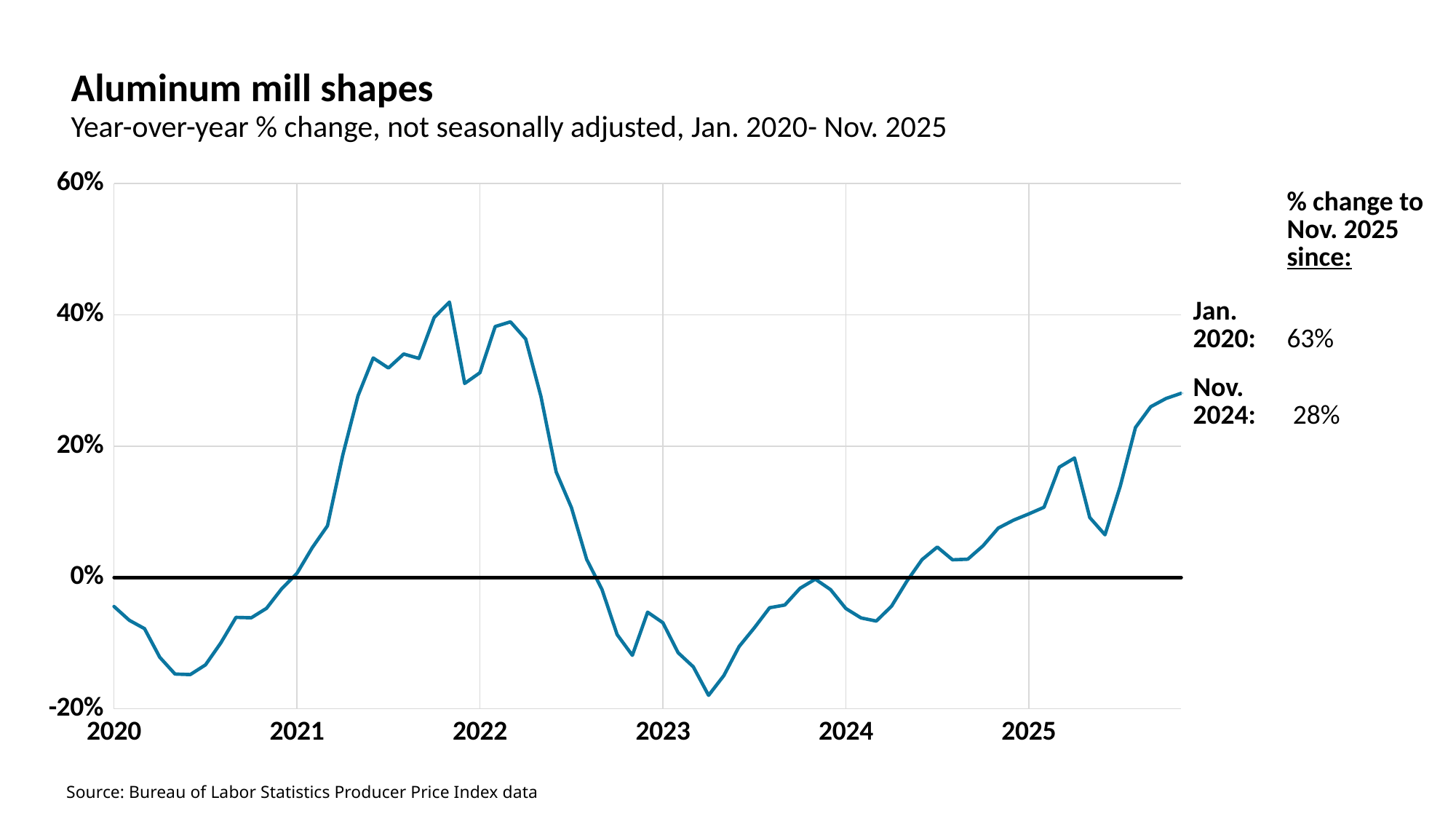
What is the title of the chart? Aluminum mill shapes How many year labels are shown on the x axis? 6 Does the year-over-year % change rise or fall between the start of 2022 and the start of 2023? fall According to the annotation, what is the % change to Nov. 2025 since Nov. 2024? 28% Is the year-over-year % change at the end of the series (Nov. 2025) greater or less than 20%? greater Is the year-over-year % change at the start of 2020 greater or less than 0%? less Is the year-over-year % change at the start of 2023 greater or less than 0%? less According to the annotation, what is the % change to Nov. 2025 since Jan. 2020? 63% Which is higher: the peak of the line in 2021 or the peak of the line in 2025? 2021 What kind of chart is shown on the slide? line chart